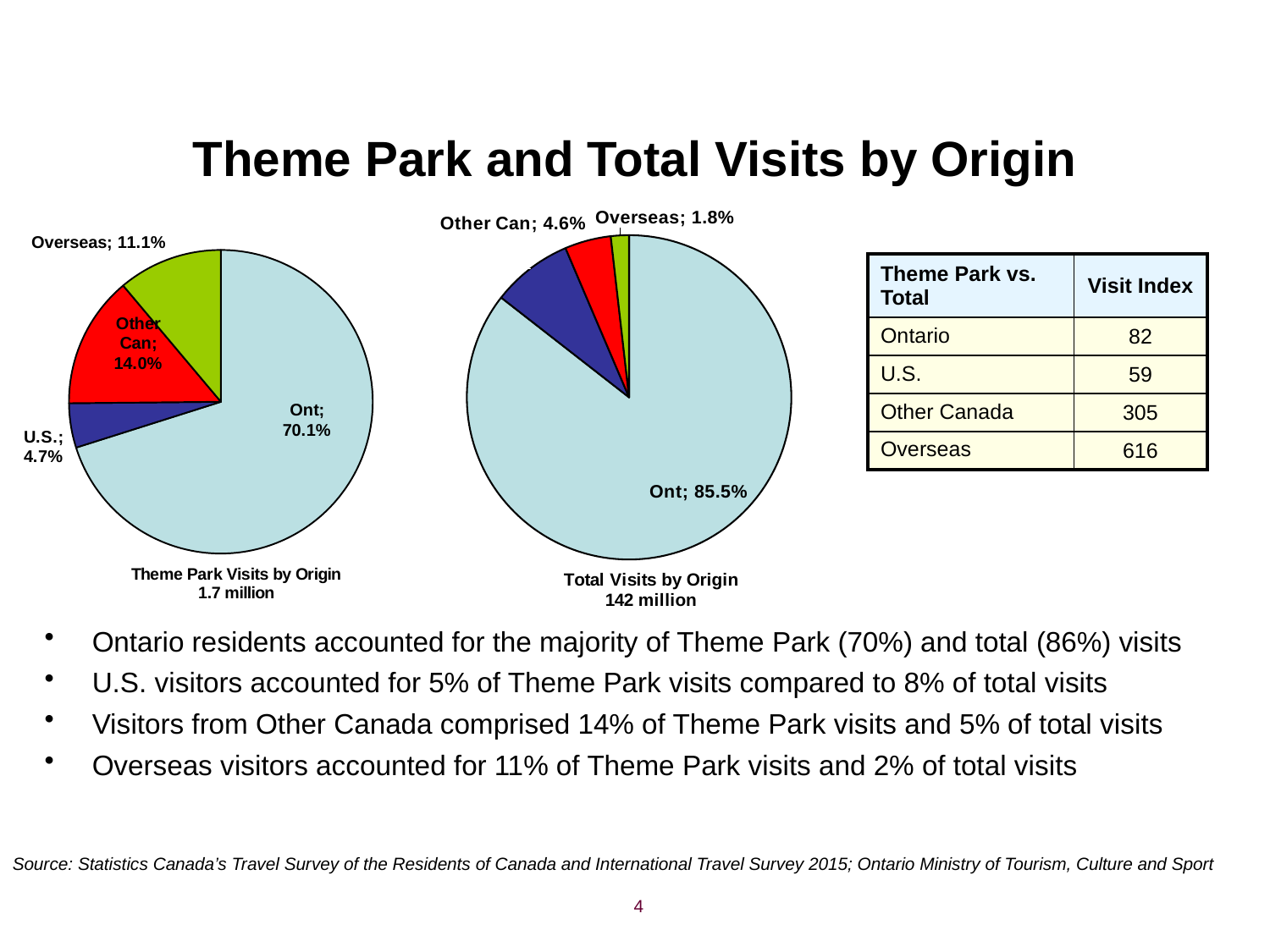
In the Total Visits by Origin chart, what share of visits came from Ontario? 85.5% Which is larger: the Overseas share in the Theme Park Visits by Origin chart or the Overseas share in the Total Visits by Origin chart? Theme Park Visits by Origin In the Theme Park Visits by Origin chart, what is the difference between the Other Can share and the Overseas share? 2.9% What type of chart is used for Total Visits by Origin? Pie chart In the Total Visits by Origin chart, which origin has the largest slice? Ont How many slices does the Theme Park Visits by Origin chart have? 4 In the Theme Park Visits by Origin chart, what share of visits came from Other Canada? 14.0% In the Theme Park Visits by Origin chart, what share of visits came from the U.S.? 4.7% In the Theme Park Visits by Origin chart, what share of visits came from Ontario? 70.1% In the Total Visits by Origin chart, what share of visits came from Overseas? 1.8% What total number of visits is shown under the Theme Park Visits by Origin chart? 1.7 million In the Theme Park Visits by Origin chart, which origin has the smallest slice? U.S.